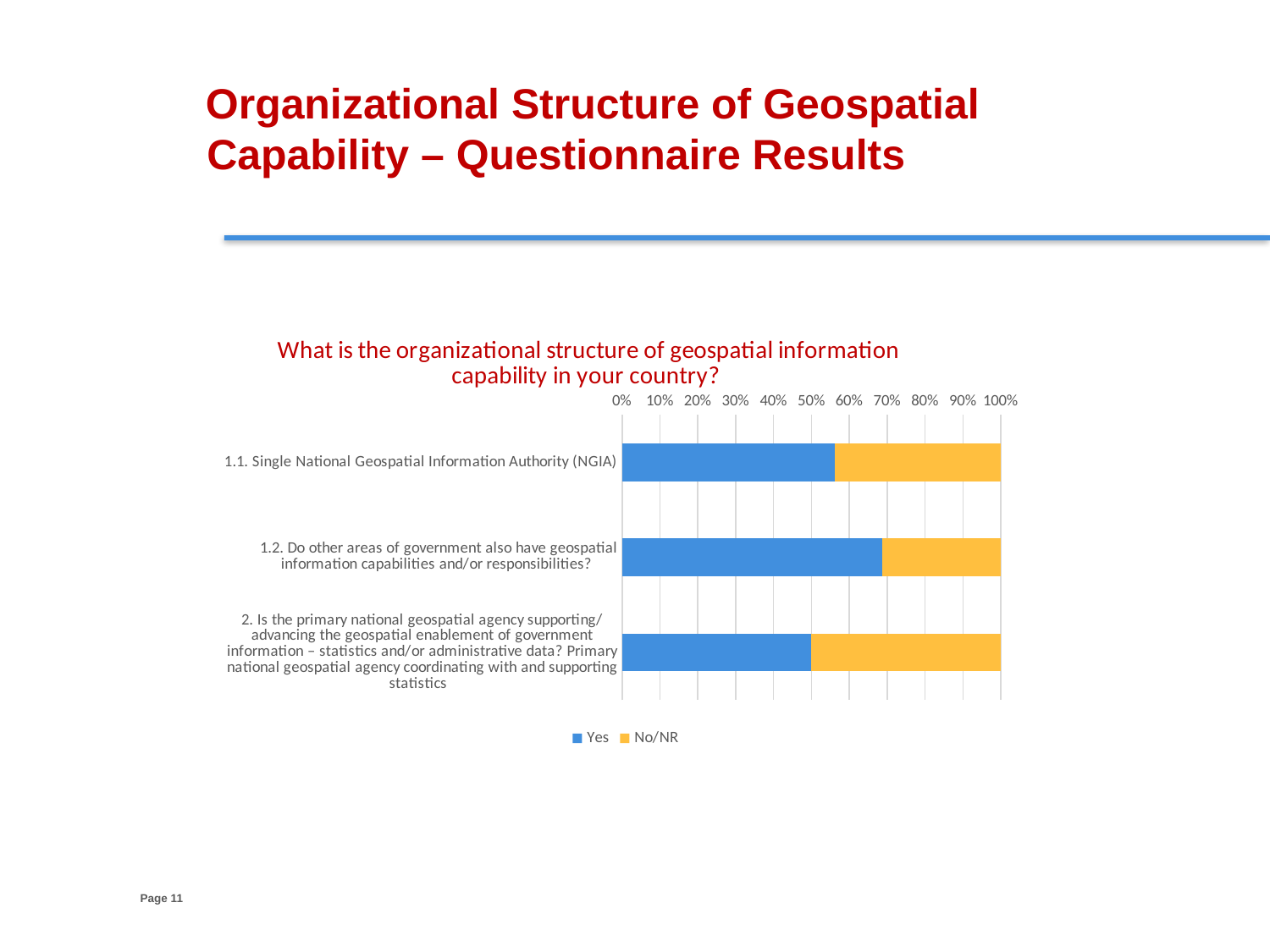
Is the 'Yes' value for '1.1. Single National Geospatial Information Authority (NGIA)' greater or less than 50%? greater Is the 'No/NR' value for '1.2. Do other areas of government also have geospatial information capabilities and/or responsibilities?' greater or less than 40%? less What kind of chart is shown on the slide? Stacked bar chart Is the 'Yes' value for '1.2. Do other areas of government also have geospatial information capabilities and/or responsibilities?' greater or less than 60%? greater How many categories (questions) are plotted on the chart? 3 Which has a larger 'Yes' share: question 1.2 or question 2? Question 1.2 What is the title of the chart? What is the organizational structure of geospatial information capability in your country? Which has a larger 'No/NR' share: question 1.1 or question 1.2? Question 1.1 Which category has the largest 'Yes' share? 1.2. Do other areas of government also have geospatial information capabilities and/or responsibilities? What are the two series named in the legend? Yes and No/NR How many series does the legend list? 2